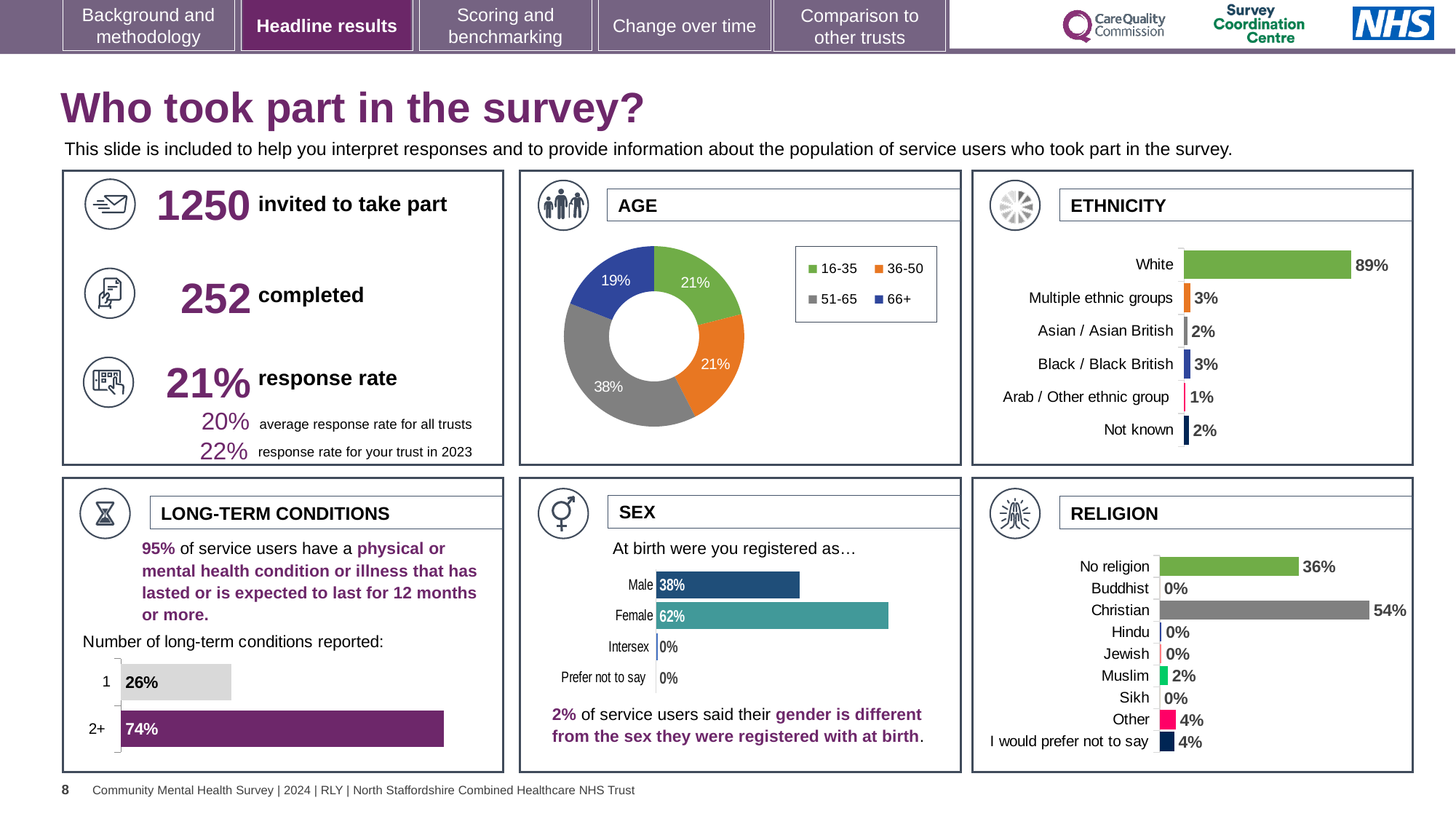
In the ETHNICITY chart, which category has the lowest value? Arab / Other ethnic group How many age groups does the legend of the AGE chart list? 4 What kind of chart is the AGE chart? Doughnut (pie) chart In the LONG-TERM CONDITIONS chart, what percentage reported 2+ conditions? 74% In the SEX chart, what is the value for Female? 62% In the AGE chart, which age group has the smallest share? 66+ In the AGE chart, what share of respondents were aged 51-65? 38% In the ETHNICITY chart, what is the difference between White and Multiple ethnic groups? 86% In the ETHNICITY chart, what is the value for White? 89% In the SEX chart, which is larger, Male or Female? Female In the RELIGION chart, which category has the highest value? Christian In the RELIGION chart, what is the difference between Christian and No religion? 18%